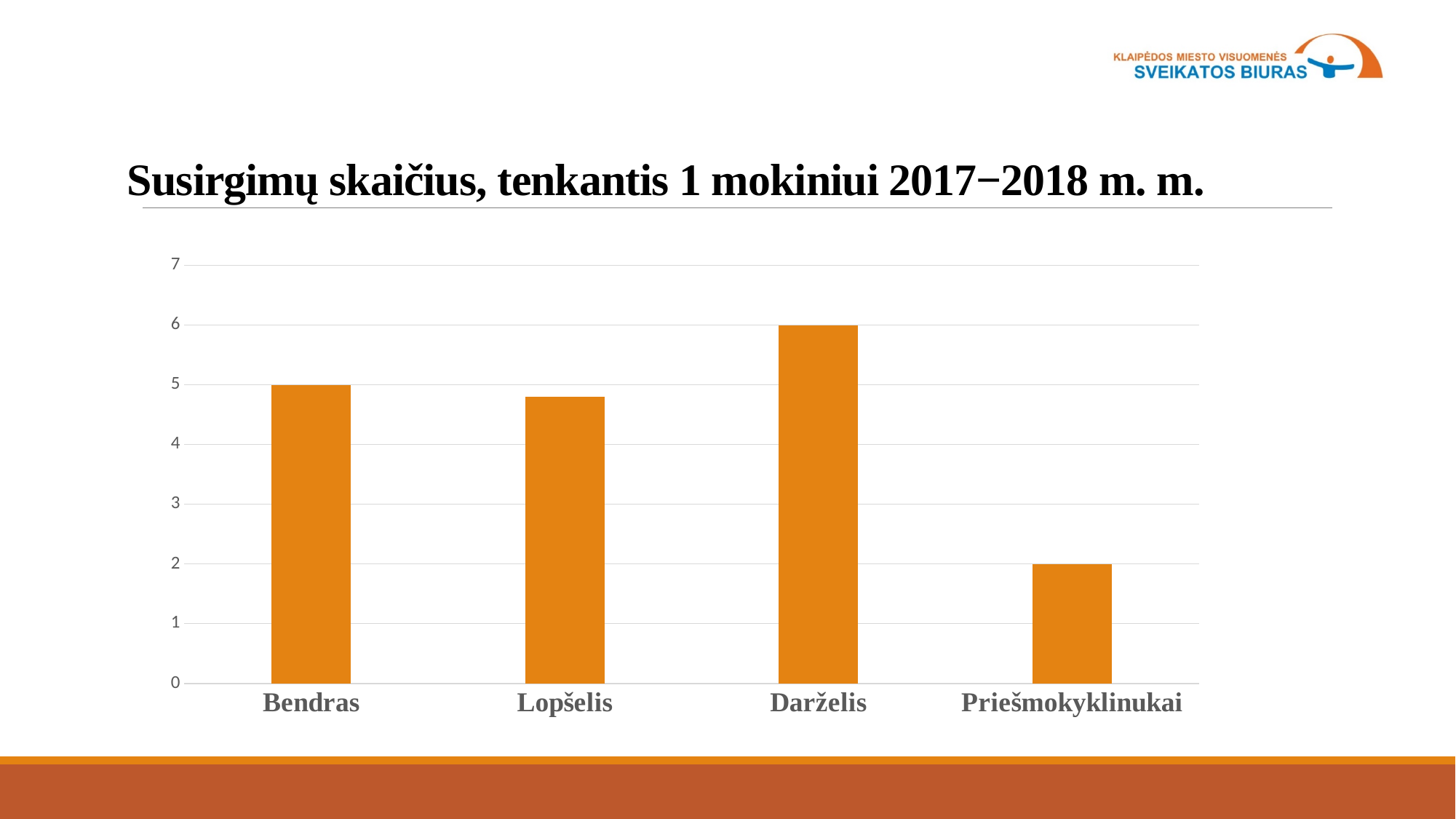
What colour are the bars in the chart? Orange What is the value for Priešmokyklinukai? 2 Which is larger, the value for Darželis or the value for Bendras? Darželis What type of chart is shown on the slide? Bar chart What is the value for Darželis? 6 What is the difference between the values for Darželis and Priešmokyklinukai? 4 Is the value for Lopšelis greater or less than 5? less Which category has the lowest value? Priešmokyklinukai Which category has the highest value? Darželis How many categories are shown on the x axis? 4 What is the value for Bendras? 5 What is the title of the chart? Susirgimų skaičius, tenkantis 1 mokiniui 2017−2018 m. m.